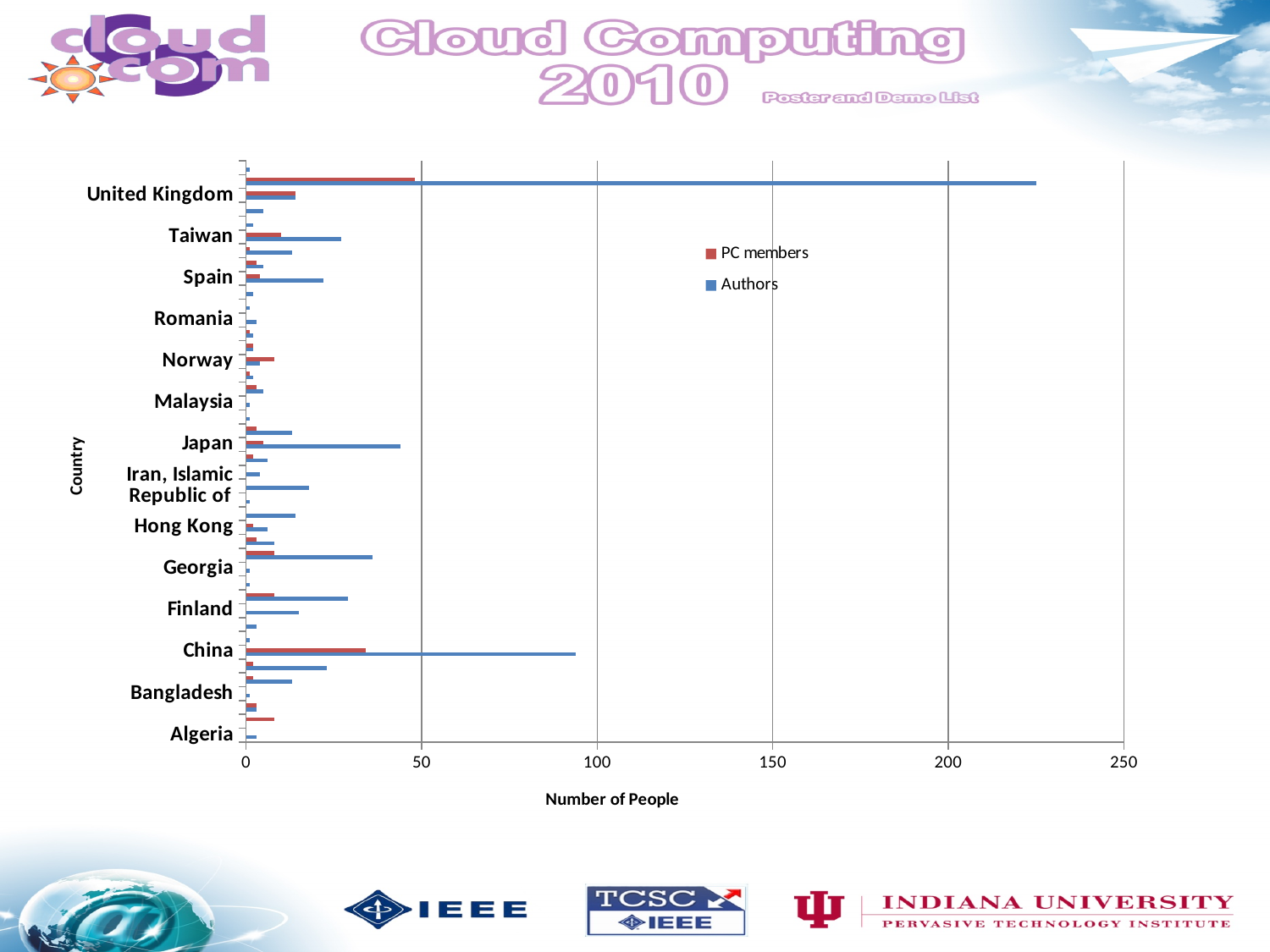
How many series does the legend list? 2 Is the Authors value for Taiwan greater or less than 50? less For China, which is larger: Authors or PC members? Authors Is the longest Authors bar greater or less than 200? greater Is the PC members value for China greater or less than 50? less Which series has the longest bar on the chart? Authors Which country has more Authors, China or Japan? China What kind of chart is shown on the slide? bar chart What are the two series named in the legend? PC members and Authors What is the title of the horizontal axis? Number of People